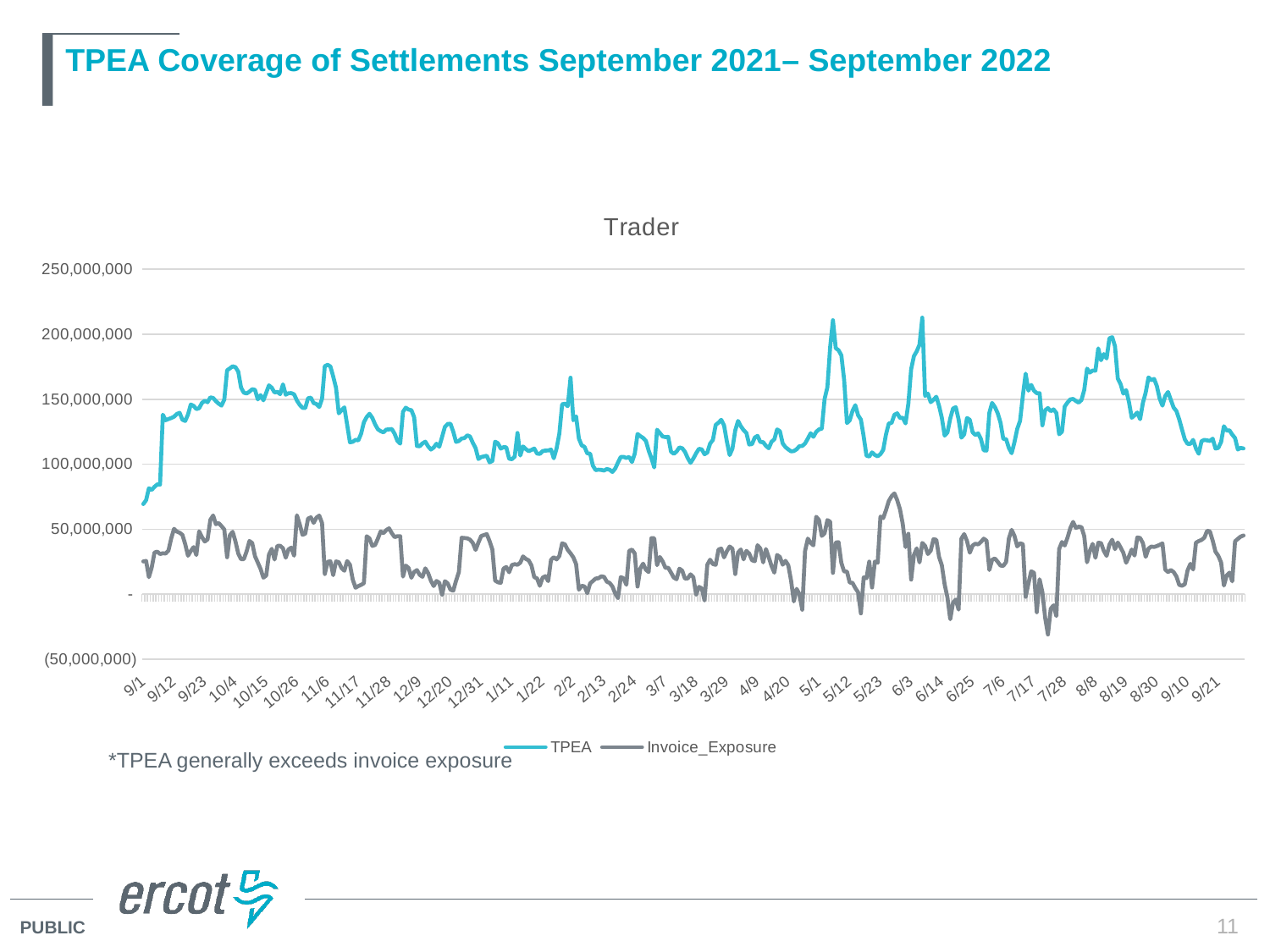
What is the highest value shown on the y axis? 250,000,000 What is the title of the chart? Trader Is the TPEA value at 10/4 greater or less than 150,000,000? greater Which series is drawn in the light blue colour? TPEA How many series does the legend list? 2 What kind of chart is shown on the slide? line chart Is the TPEA value at 9/1 greater or less than 100,000,000? less How many date labels are shown on the x axis? 36 Which series reaches the highest value on the chart? TPEA Which series is higher at 10/4, TPEA or Invoice_Exposure? TPEA Is the Invoice_Exposure value at 9/1 greater or less than 50,000,000? less